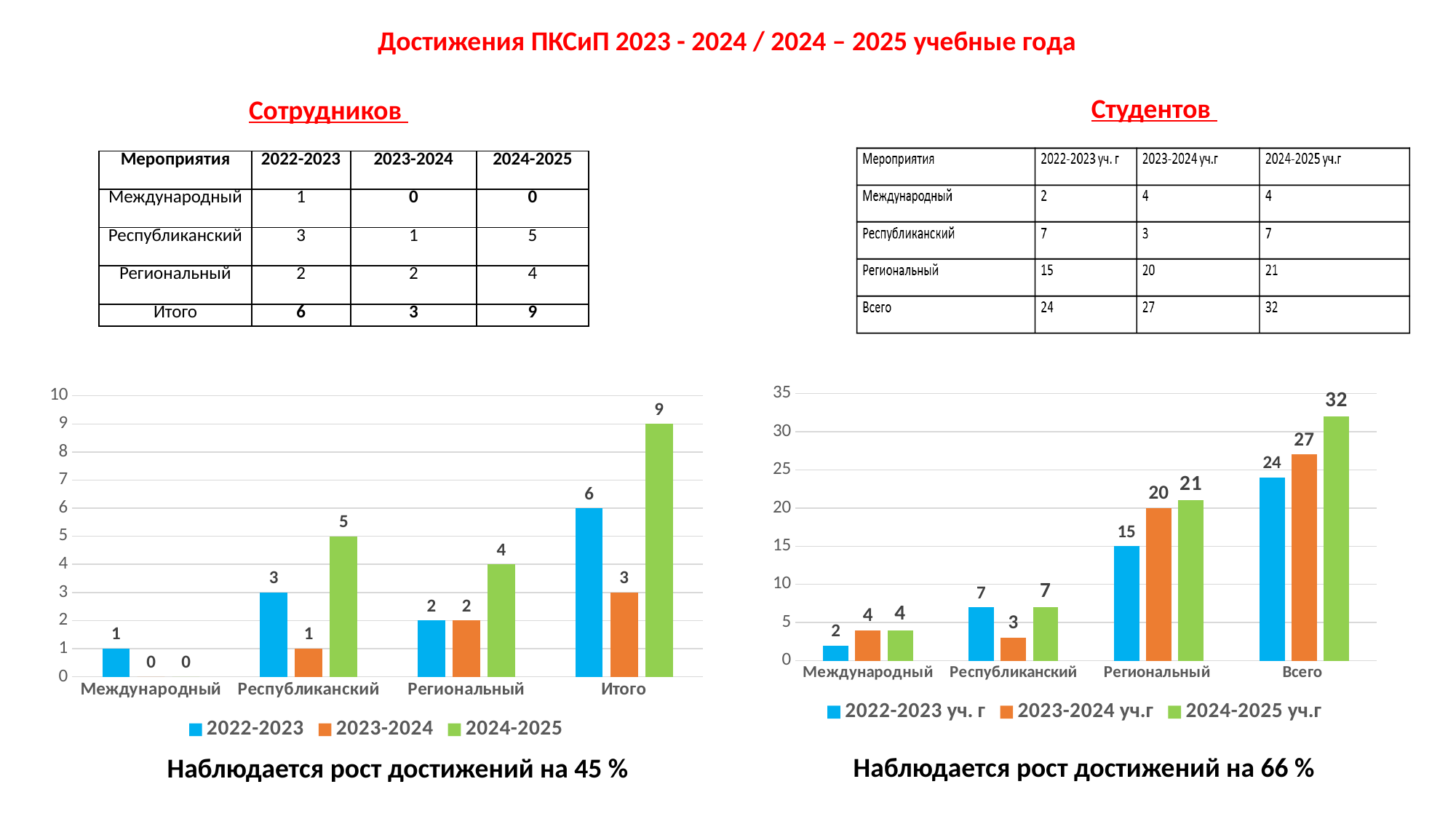
In the right chart (Студентов), which category has the lowest value in the 2022-2023 уч. г series? Международный In the right chart (Студентов), what is the value for Всего in the 2024-2025 уч.г series? 32 In the left chart (Сотрудников), how many series does the legend list? 3 In the right chart (Студентов), what is the difference between the Всего values for 2024-2025 уч.г and 2022-2023 уч. г? 8 In the left chart (Сотрудников), what is the value for Республиканский in the 2024-2025 series? 5 In the left chart (Сотрудников), what is the value for Итого in the 2023-2024 series? 3 In the left chart (Сотрудников), what is the difference between the 2024-2025 and 2022-2023 values for Итого? 3 In the right chart (Студентов), what is the value for Региональный in the 2023-2024 уч.г series? 20 In the left chart (Сотрудников), which category has the highest value in the 2024-2025 series? Итого How many categories are shown on the x axis of the right chart (Студентов)? 4 In the right chart (Студентов), which is larger for Республиканский: the 2022-2023 уч. г value or the 2023-2024 уч.г value? 2022-2023 уч. г What kind of chart is the left chart (Сотрудников)? Bar chart